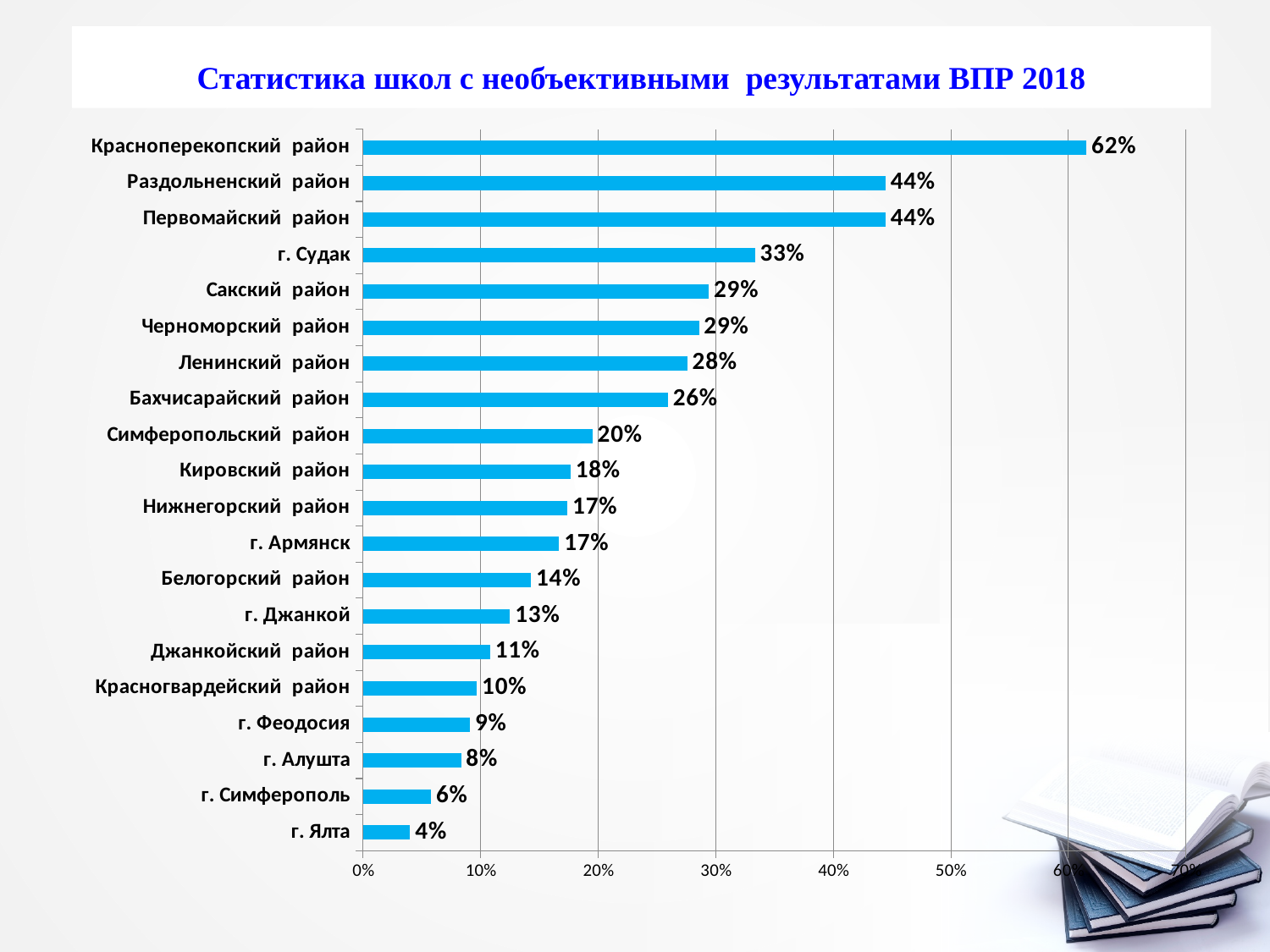
What is the difference between the values for Симферопольский район and г. Симферополь? 14% What is the value for г. Феодосия? 9% How many categories are shown in the chart? 20 Which category has the highest value? Красноперекопский район What is the title of the chart? Статистика школ с необъективными результатами ВПР 2018 What is the value for г. Судак? 33% What kind of chart is shown on the slide? bar chart What is the value for Красноперекопский район? 62% Which category has the lowest value? г. Ялта What is the value for Бахчисарайский район? 26% What is the difference between the values for Красноперекопский район and Раздольненский район? 18% Which is larger, the value for Ленинский район or the value for Кировский район? Ленинский район